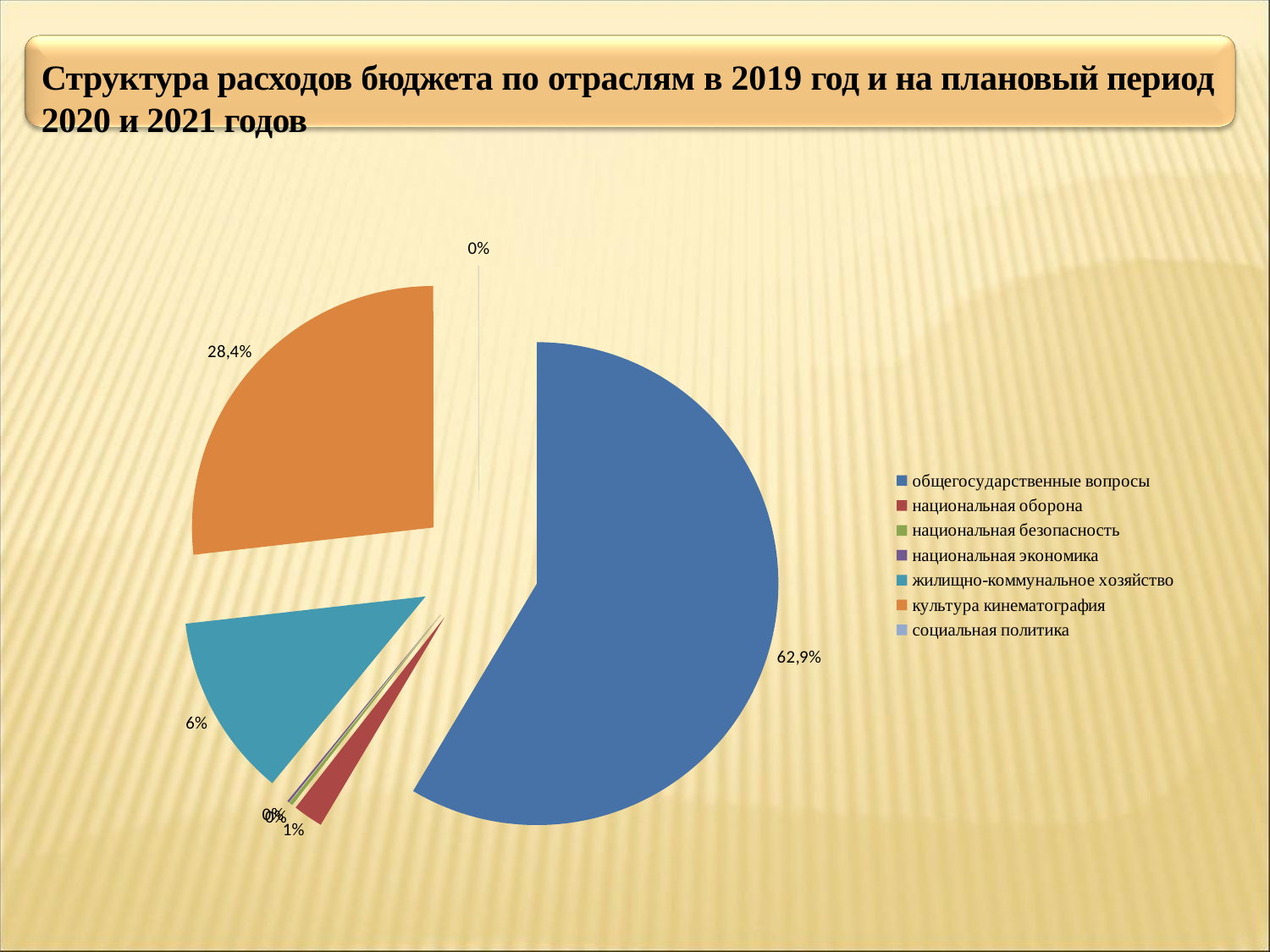
What is the difference in percentage points between the "общегосударственные вопросы" slice and the "культура кинематография" slice? 34,5% How many categories does the legend of the pie chart list? 7 What share of the pie does "национальная оборона" have? 1% What kind of chart is shown on the slide? pie chart Which category has the largest slice of the pie? общегосударственные вопросы Which is larger: the slice for "культура кинематография" or the slice for "жилищно-коммунальное хозяйство"? культура кинематография What share of the pie does "культура кинематография" have? 28,4% What share of the pie does "общегосударственные вопросы" have? 62,9% Is the share for "общегосударственные вопросы" greater or less than 50%? greater What colour is the slice for "культура кинематография"? orange What share of the pie does "жилищно-коммунальное хозяйство" have? 6% What is the title of the slide containing the pie chart? Структура расходов бюджета по отраслям в 2019 год и на плановый период 2020 и 2021 годов